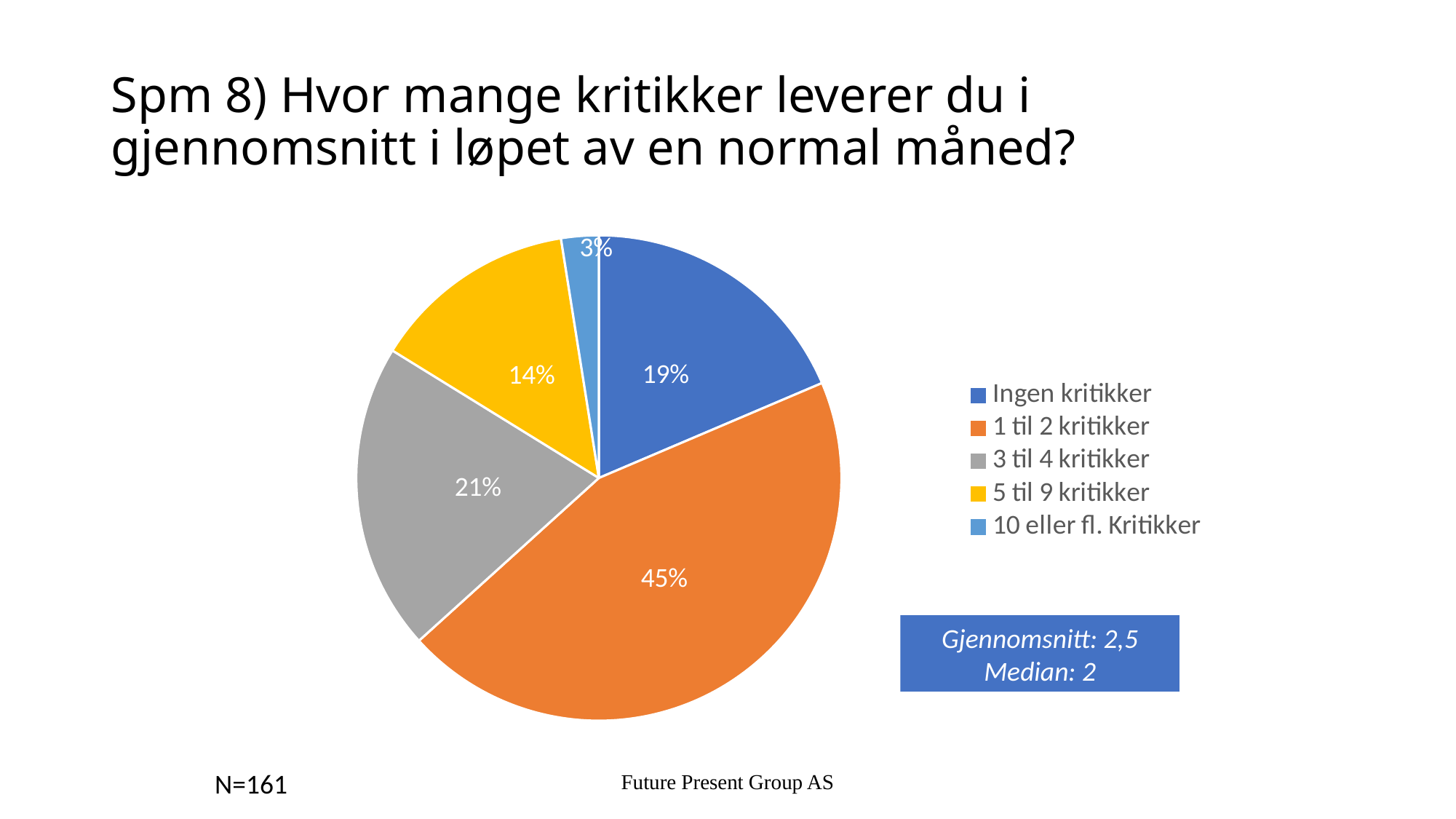
Which category has the smallest slice of the pie? 10 eller fl. Kritikker What share of the pie is labelled "5 til 9 kritikker"? 14% What colour is the slice for "3 til 4 kritikker"? grey Which category has the largest slice of the pie? 1 til 2 kritikker What share of the pie is labelled "1 til 2 kritikker"? 45% What kind of chart is shown on the slide? pie chart What share of the pie is labelled "3 til 4 kritikker"? 21% How many categories does the pie chart have? 5 Which slice is larger, "Ingen kritikker" or "5 til 9 kritikker"? Ingen kritikker What is the difference in percentage points between the "1 til 2 kritikker" slice and the "3 til 4 kritikker" slice? 24